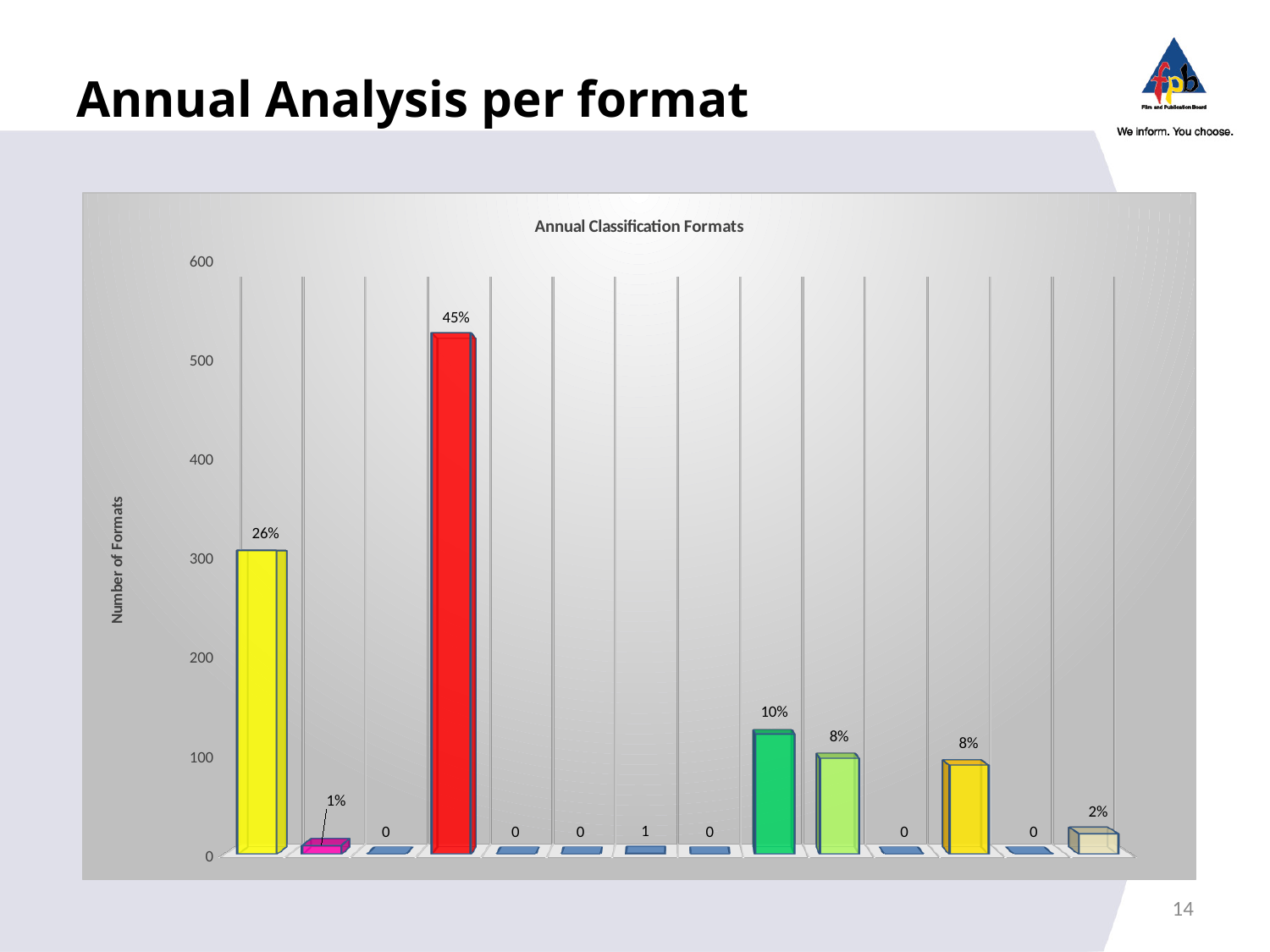
What data label is shown on the magenta bar, second from the left? 1% What kind of chart is shown on the slide? bar chart What data label is shown on the tallest (red) bar? 45% How many bars are plotted in the chart? 14 What is the title of the chart? Annual Classification Formats What data label is shown on the bright green bar? 10% What data label is shown on the beige bar at the far right of the chart? 2% What is the label on the vertical axis of the chart? Number of Formats What data label is shown on the yellow bar at the far left of the chart? 26% How many bars in the chart carry a data label of 0? 6 Which bar is taller, the yellow bar on the far left or the bright green bar? the yellow bar Is the value of the red bar greater or less than 500 on the vertical axis? greater